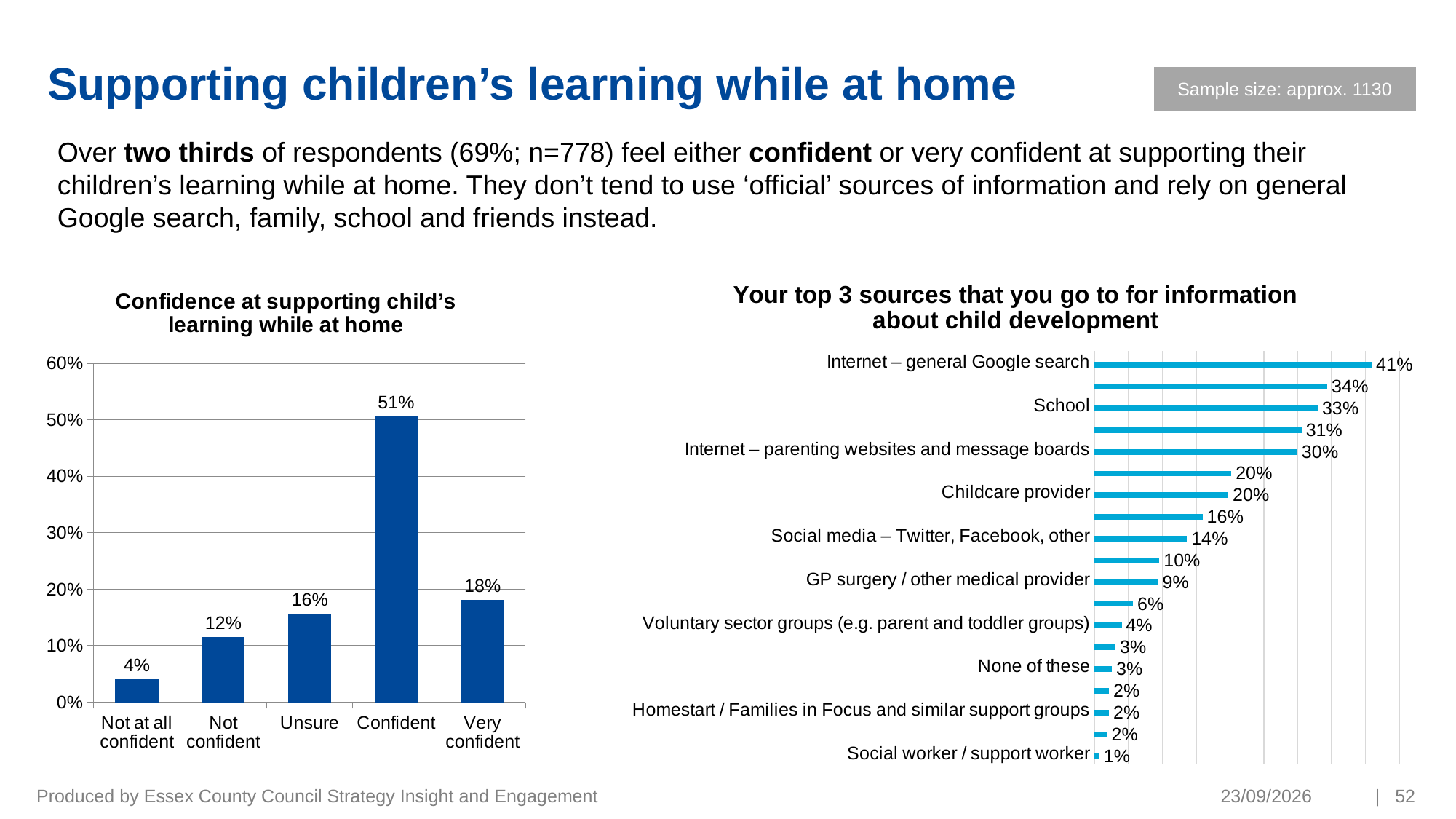
In the chart 'Confidence at supporting child's learning while at home', what percentage of respondents are Confident? 51% In the chart 'Your top 3 sources that you go to for information about child development', what is the value for Internet – general Google search? 41% In the chart 'Your top 3 sources that you go to for information about child development', what is the difference between Childcare provider and GP surgery / other medical provider? 11% In the chart 'Confidence at supporting child's learning while at home', which is larger: Unsure or Not confident? Unsure In the chart 'Confidence at supporting child's learning while at home', what is the value for Not at all confident? 4% In the chart 'Confidence at supporting child's learning while at home', which category has the lowest value? Not at all confident In the chart 'Confidence at supporting child's learning while at home', what is the difference between Confident and Very confident? 33% In the chart 'Confidence at supporting child's learning while at home', which category has the highest value? Confident In the chart 'Your top 3 sources that you go to for information about child development', what is the value for School? 33% How many categories are shown in the chart 'Confidence at supporting child's learning while at home'? 5 In the chart 'Your top 3 sources that you go to for information about child development', which source has the lowest value? Social worker / support worker What type of chart is 'Confidence at supporting child's learning while at home'? Bar chart